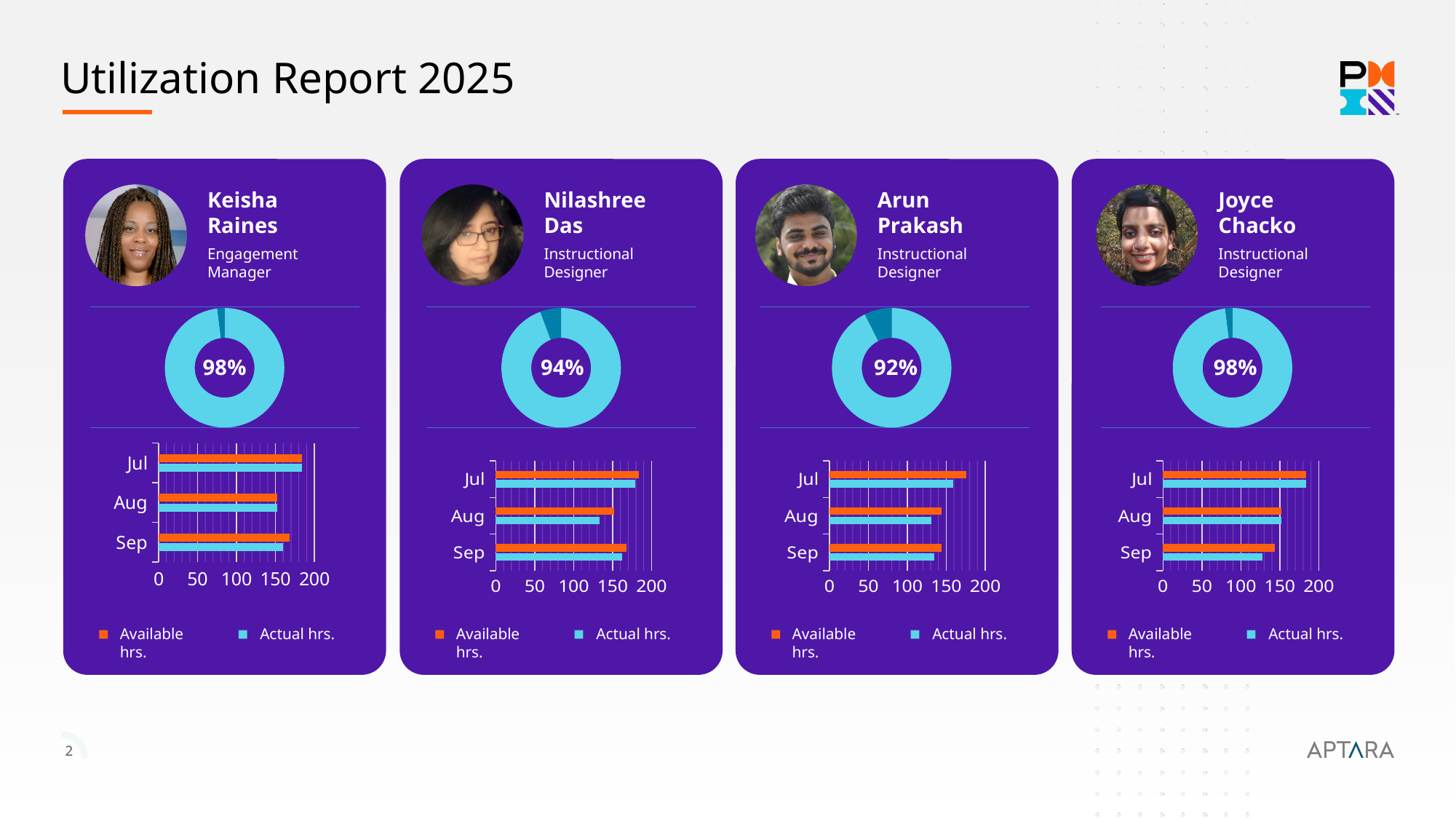
What kind of chart is shown below the donut in each card? Bar chart How many months are shown on Joyce Chacko's bar chart? 3 How many series does the legend list on Nilashree Das's bar chart? 2 On Nilashree Das's bar chart, is the Actual hrs. value for Aug greater or less than 150? less What is the difference between Keisha Raines's and Arun Prakash's donut chart percentages? 6% On Joyce Chacko's bar chart, which series is shown in orange? Available hrs. Across the four donut charts, which person has the lowest utilization percentage? Arun Prakash On Arun Prakash's donut chart, what utilization percentage is shown? 92% On Keisha Raines's donut chart, what utilization percentage is shown? 98% On Nilashree Das's donut chart, what utilization percentage is shown? 94% On Keisha Raines's bar chart, is the Available hrs. value for Jul greater or less than 150? greater On Arun Prakash's bar chart, which month has the highest Available hrs.? Jul